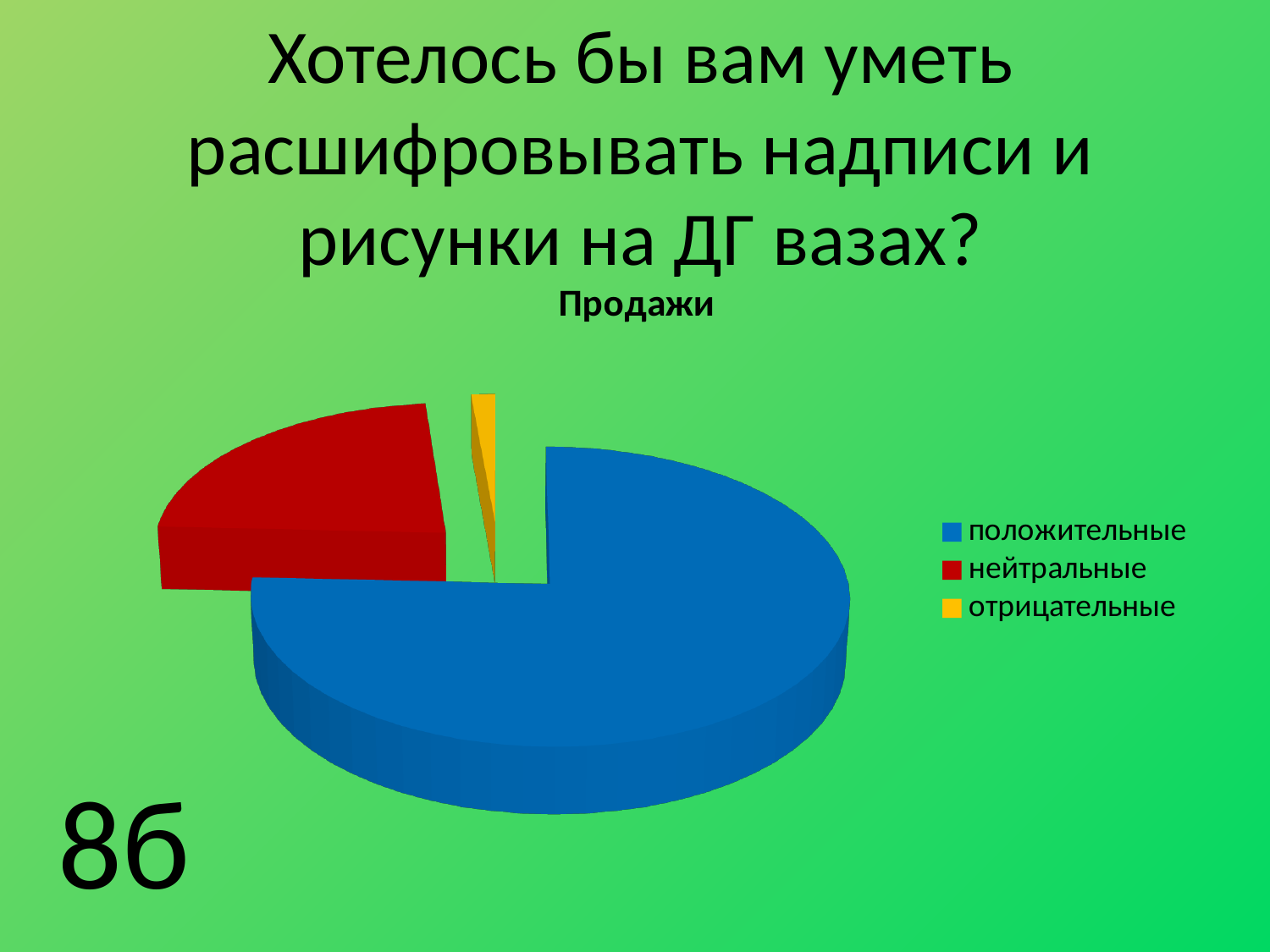
Which category has the smallest slice of the pie? отрицательные Which category has the largest slice of the pie? положительные Which slice is larger, нейтральные or отрицательные? нейтральные What colour is the slice for нейтральные? red Which slice is larger, положительные or нейтральные? положительные What is the title of the chart? Продажи How many slices does the pie chart have? 3 What kind of chart is shown on the slide? pie chart How many entries does the legend list? 3